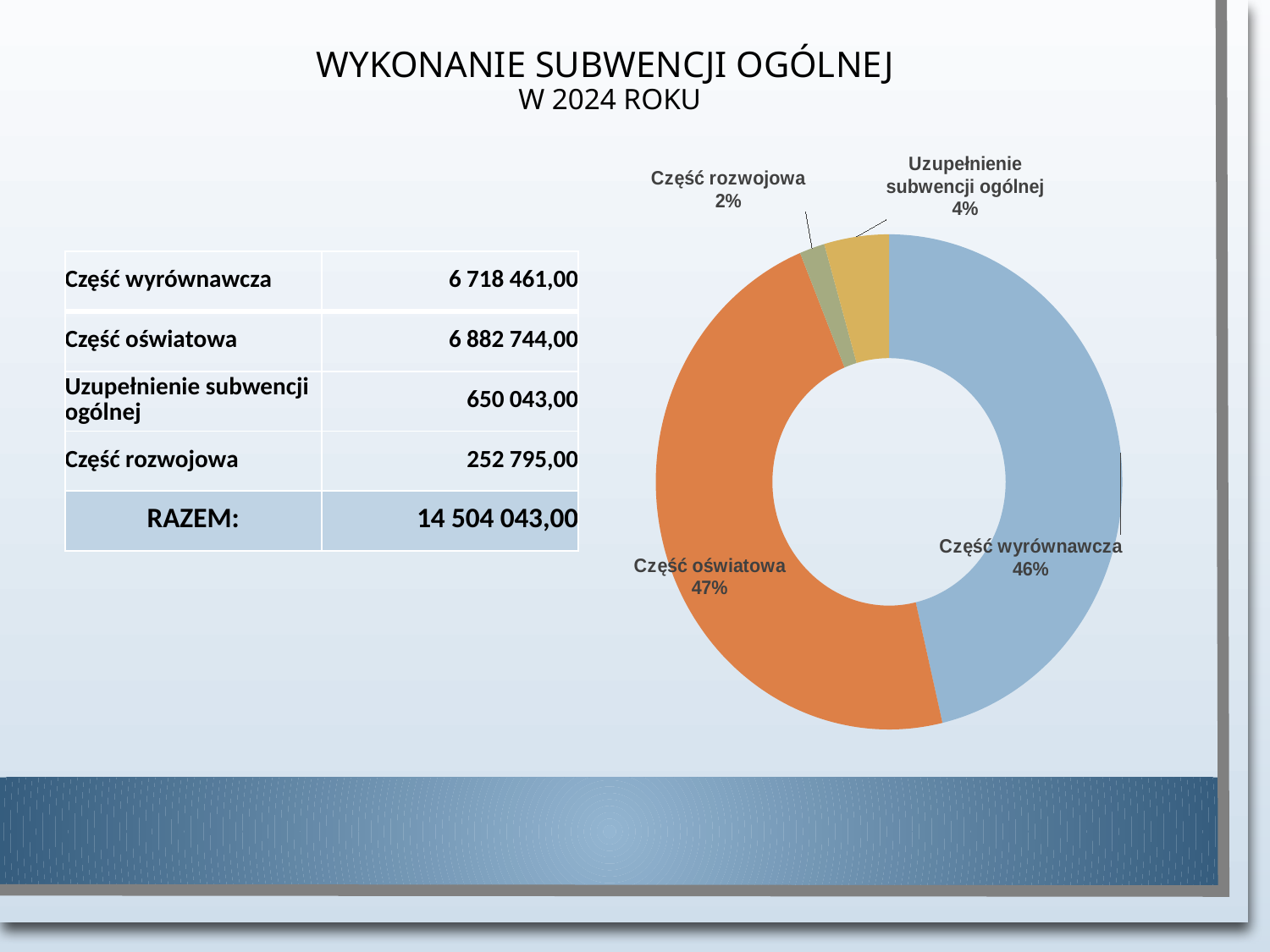
What colour is the Część oświatowa slice in the chart? Orange Which has a larger share in the chart, Część wyrównawcza or Uzupełnienie subwencji ogólnej? Część wyrównawcza What percentage is shown for Część rozwojowa in the chart? 2% By how many percentage points does the share of Część oświatowa exceed that of Część wyrównawcza? 1 How many categories are shown in the chart? 4 What share of the doughnut chart does Część oświatowa represent? 47% What colour is the Część wyrównawcza slice in the chart? Blue Which category has the smallest share in the chart? Część rozwojowa What share of the doughnut chart does Część wyrównawcza represent? 46% What kind of chart is shown on the slide? Doughnut chart What percentage is shown for Uzupełnienie subwencji ogólnej in the chart? 4% Which category has the largest share in the chart? Część oświatowa